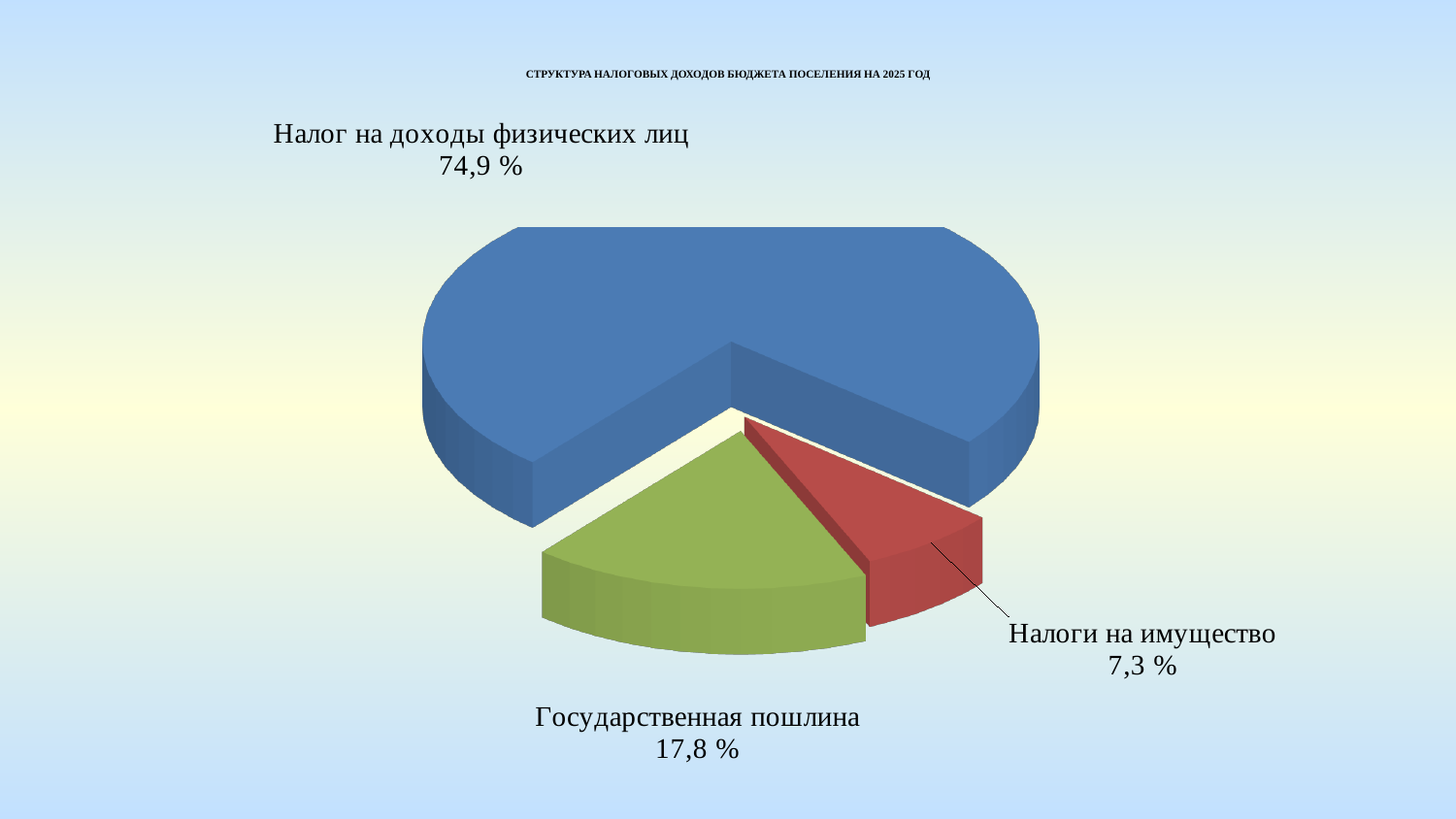
Какова доля налогов на имущество? 7,3 % Какая категория имеет наибольшую долю в структуре налоговых доходов? Налог на доходы физических лиц Какова доля налога на доходы физических лиц в структуре налоговых доходов? 74,9 % Как называется диаграмма на слайде? Структура налоговых доходов бюджета поселения на 2025 год Какова доля государственной пошлины? 17,8 % На сколько процентных пунктов доля государственной пошлины больше доли налогов на имущество? 10,5 Каким цветом показан сектор «Государственная пошлина»? Зелёным Какой тип диаграммы показан на слайде? Круговая диаграмма На сколько процентных пунктов доля налога на доходы физических лиц больше доли государственной пошлины? 57,1 Что больше: доля государственной пошлины или доля налогов на имущество? Государственная пошлина Какая категория имеет наименьшую долю? Налоги на имущество Сколько категорий показано на круговой диаграмме? 3